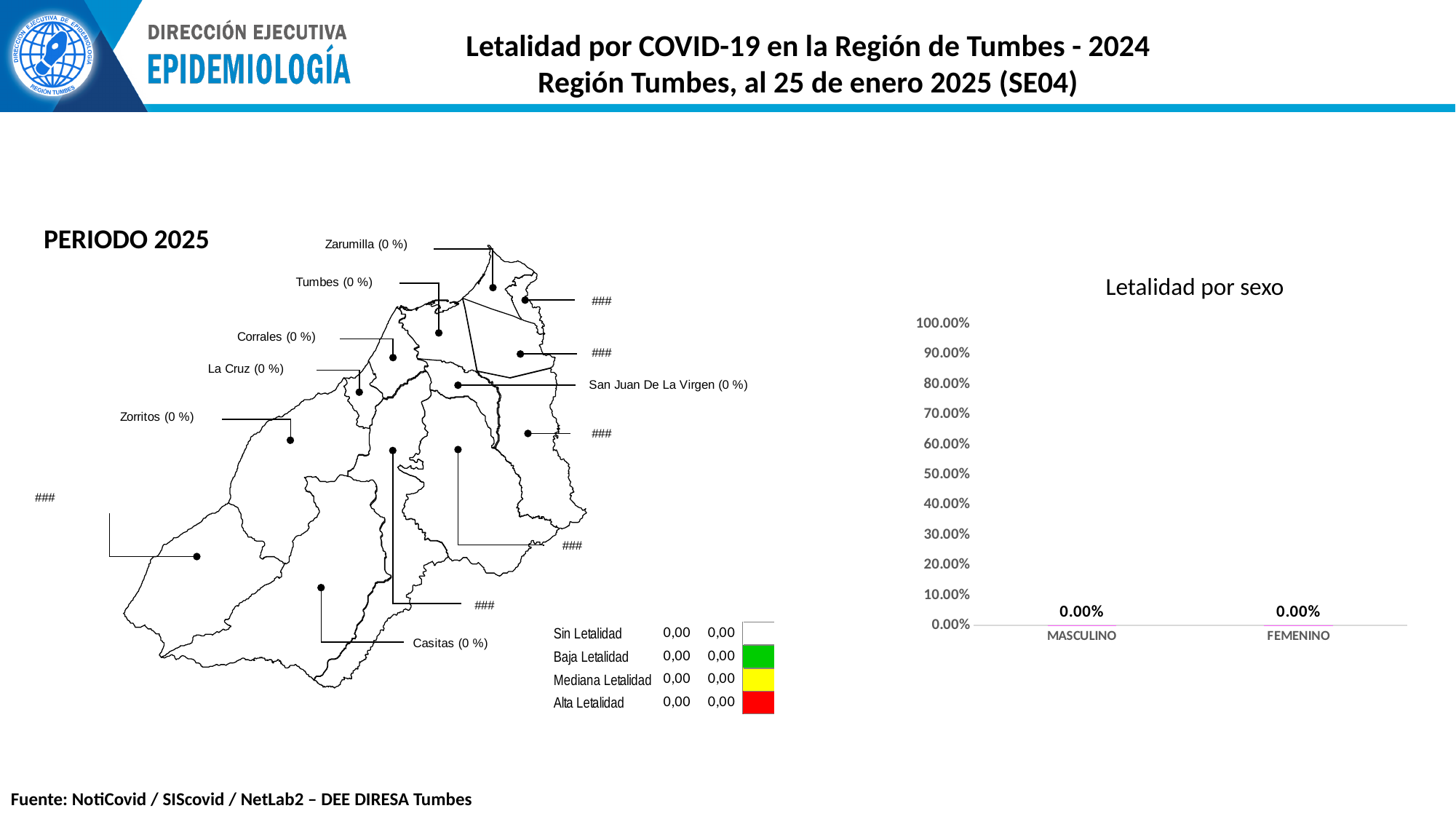
What is the highest tick value shown on the y axis of the 'Letalidad por sexo' chart? 100.00% In the 'Letalidad por sexo' chart, is the value for MASCULINO greater or less than 10.00%? less How many categories are shown on the x axis of the 'Letalidad por sexo' chart? 2 What kind of chart is 'Letalidad por sexo'? bar chart In the 'Letalidad por sexo' chart, what is the value for MASCULINO? 0.00% What is the title of the chart on the right side of the slide? Letalidad por sexo In the 'Letalidad por sexo' chart, what is the value for FEMENINO? 0.00% What is the difference between the MASCULINO and FEMENINO values in the 'Letalidad por sexo' chart? 0.00% In the 'Letalidad por sexo' chart, is the value for FEMENINO greater or less than 50.00%? less